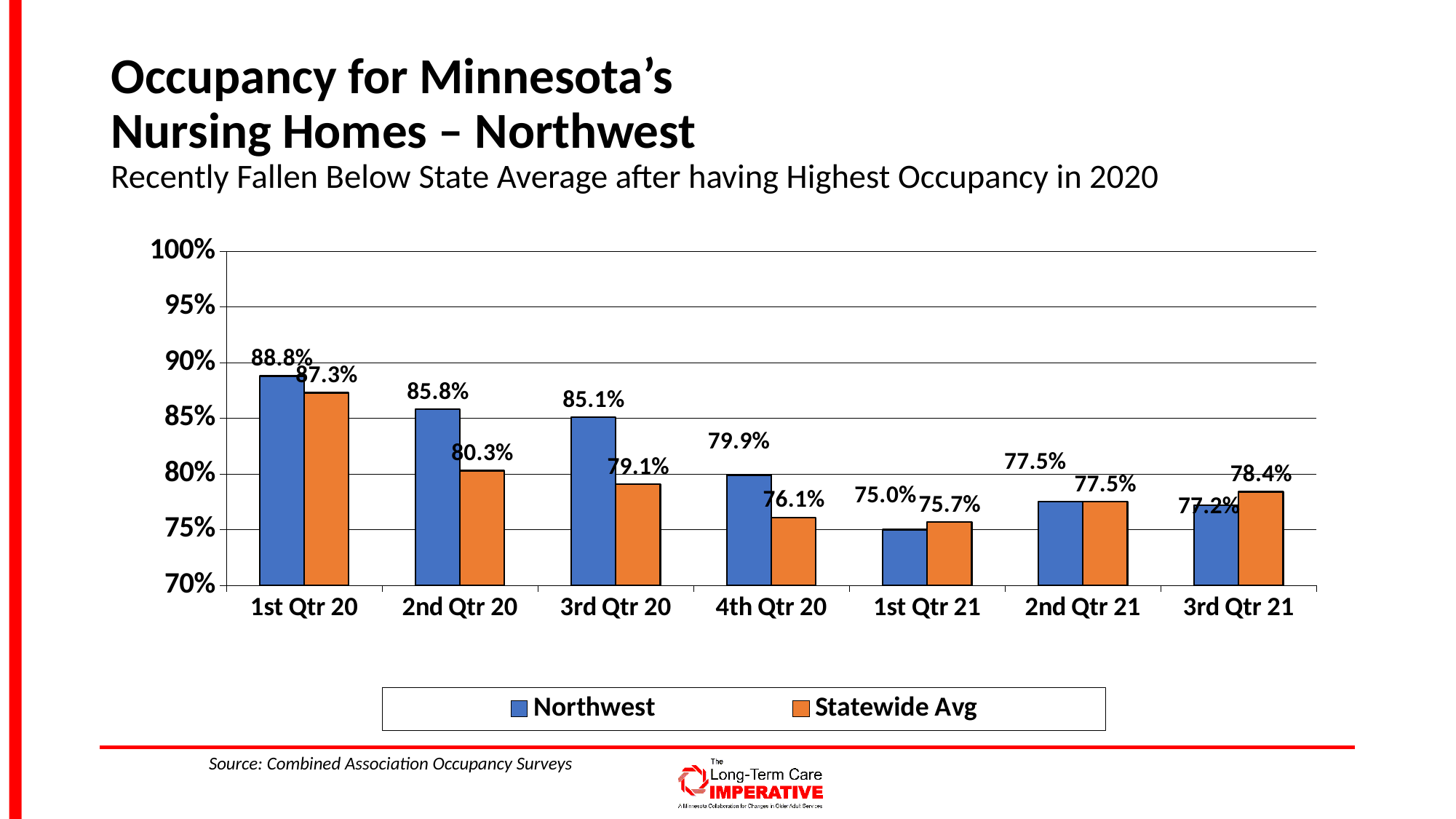
Does the Northwest occupancy rise or fall from 1st Qtr 20 to 1st Qtr 21? Fall What is the Statewide Avg occupancy value for 2nd Qtr 20? 80.3% What is the Statewide Avg occupancy value for 3rd Qtr 21? 78.4% Which is larger in 4th Qtr 20, the Northwest value or the Statewide Avg value? Northwest What is the difference between the Northwest and Statewide Avg values in 3rd Qtr 20? 6.0% How many series does the legend list? 2 In which quarter is the Northwest occupancy lowest? 1st Qtr 21 In which quarter is the Northwest occupancy highest? 1st Qtr 20 What is the Northwest occupancy value for 1st Qtr 20? 88.8% How many quarters are shown on the x axis? 7 What kind of chart is shown on the slide? Bar chart What is the Northwest occupancy value for 1st Qtr 21? 75.0%